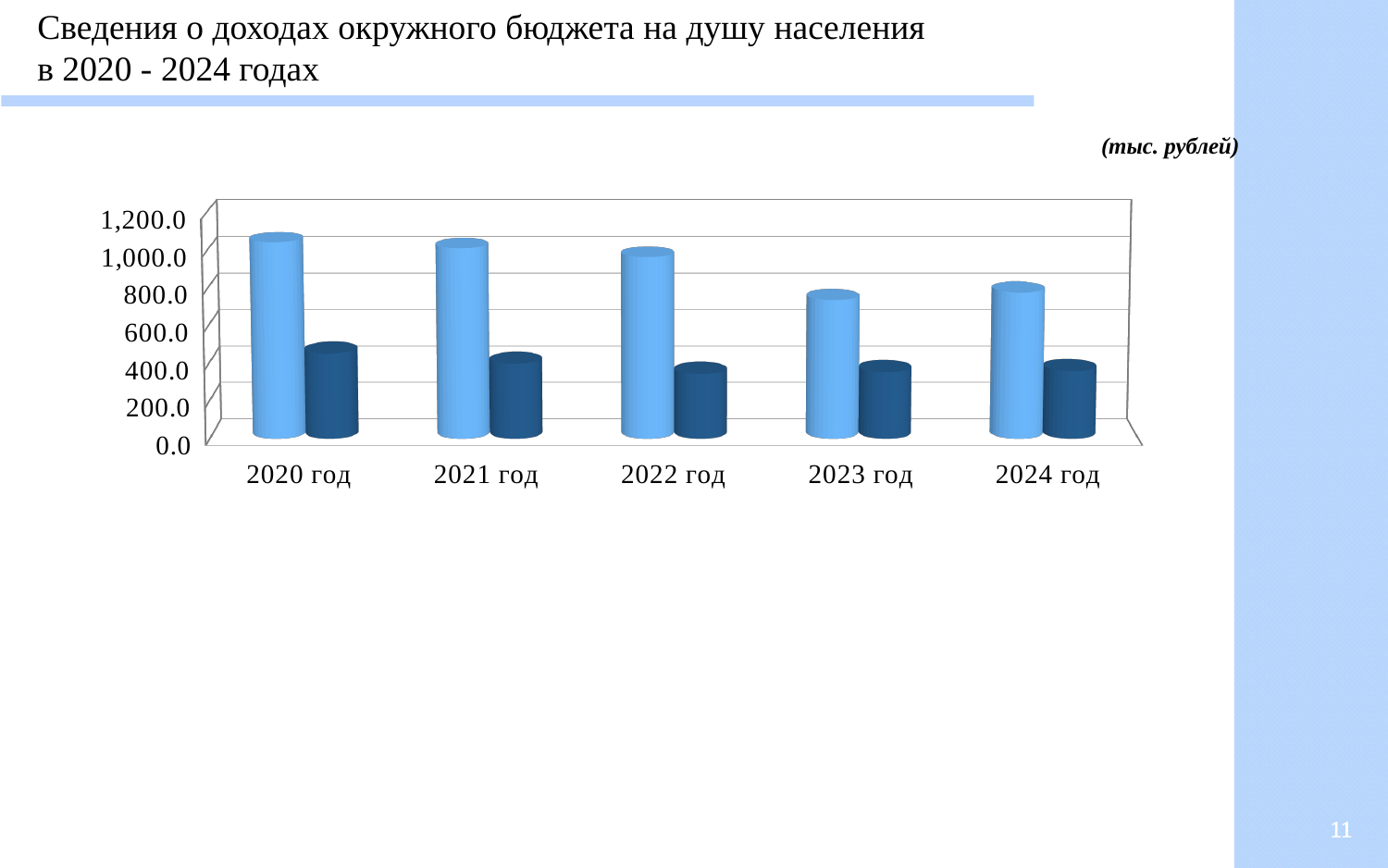
Is the value of the light blue bar for 2023 год greater or less than 600.0? greater Is the value of the dark blue bar for 2020 год greater or less than 200.0? greater What unit of measurement is indicated above the chart? тыс. рублей Which is larger, the light blue bar for 2020 год or the light blue bar for 2023 год? 2020 год How many data series are plotted in the chart? 2 How many year categories are shown on the x axis of the chart? 5 In 2020 год, which bar is taller, the light blue one or the dark blue one? the light blue one Is the value of the dark blue bar for 2022 год greater or less than 600.0? less What kind of chart is shown on the slide? bar chart Do the light blue bars overall rise or fall from 2020 год to 2024 год? fall